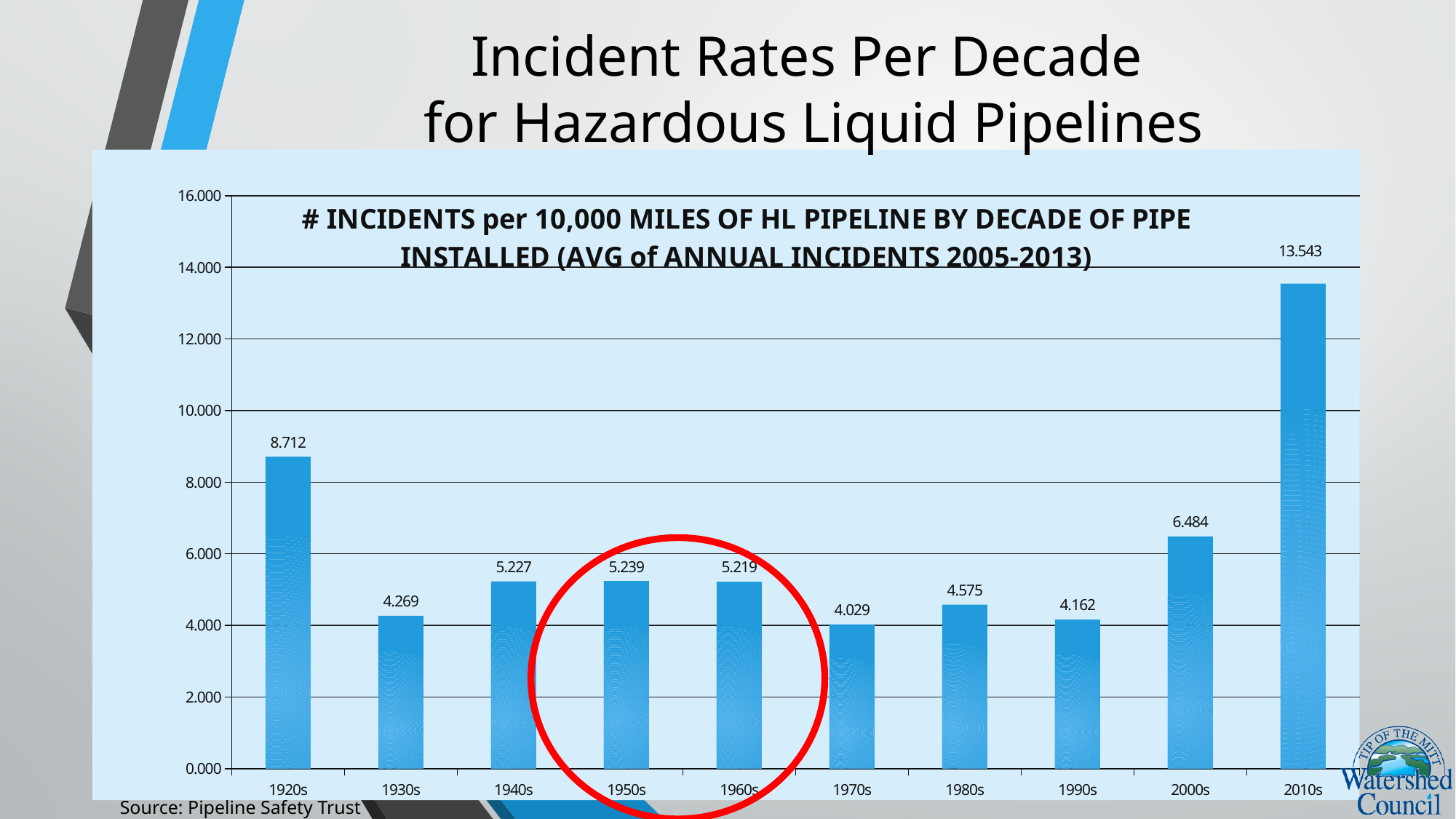
Which decade has the lowest incident rate? 1970s What is the difference between the incident rates for the 2000s and the 1990s? 2.322 Which decade has the highest incident rate? 2010s What is the incident rate for pipe installed in the 1920s? 8.712 What is the incident rate for pipe installed in the 2010s? 13.543 Which has a higher incident rate, the 1930s or the 1980s? 1980s How many decades are shown on the x axis? 10 What kind of chart is shown on the slide? Bar chart Which two decades are circled in red on the chart? 1950s and 1960s What is the incident rate for pipe installed in the 1970s? 4.029 What is the difference between the incident rates for the 2010s and the 1920s? 4.831 What is the incident rate for pipe installed in the 2000s? 6.484